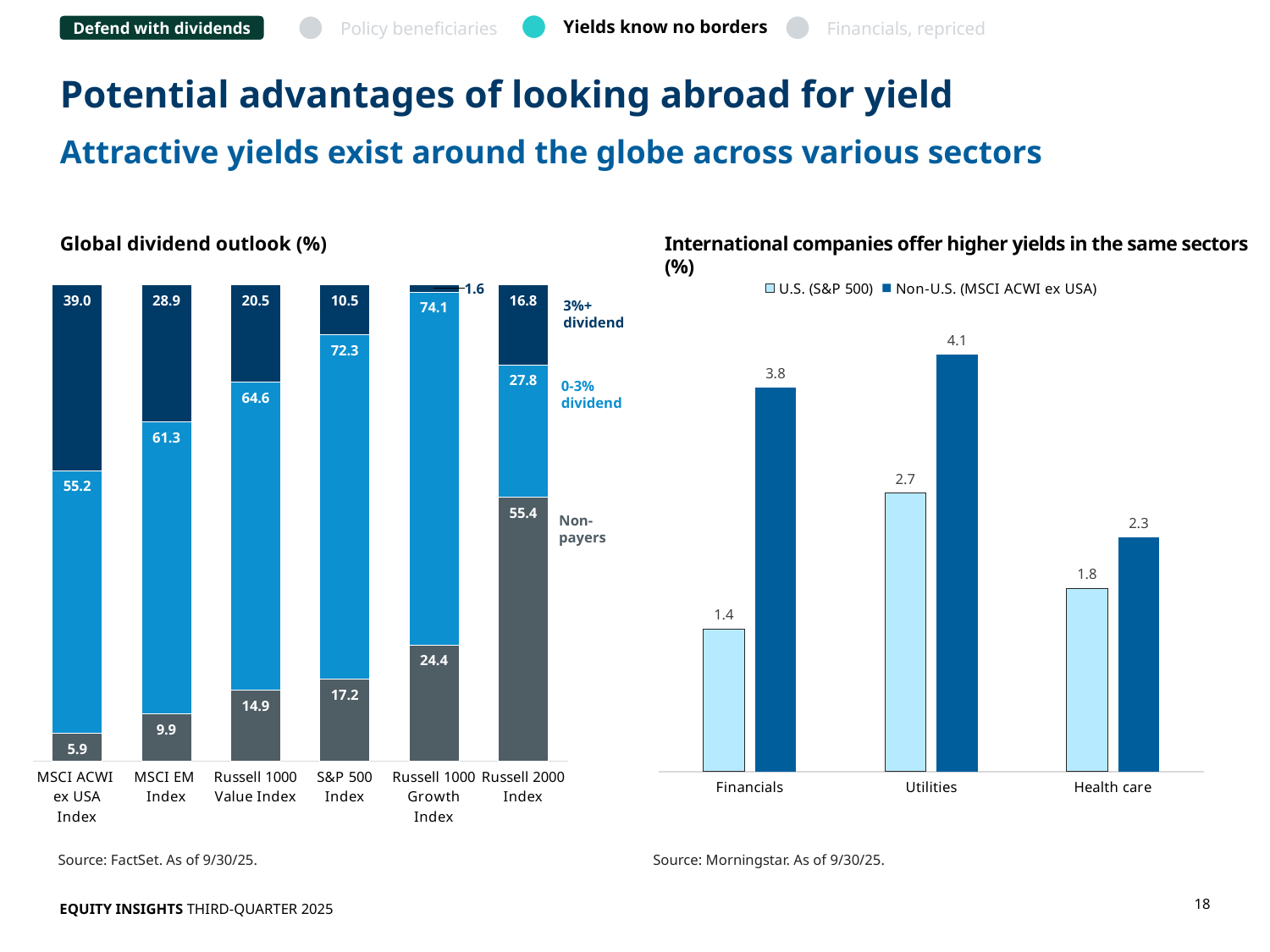
In the 'Global dividend outlook (%)' chart, which index has the lowest Non-payers value? MSCI ACWI ex USA Index In the 'Global dividend outlook (%)' chart, which index has the highest 0-3% dividend value? Russell 1000 Growth Index In the 'Global dividend outlook (%)' chart, what kind of chart is used? Stacked bar chart In the 'International companies offer higher yields in the same sectors (%)' chart, which is larger for Health care: the U.S. (S&P 500) value or the Non-U.S. (MSCI ACWI ex USA) value? Non-U.S. (MSCI ACWI ex USA) In the 'Global dividend outlook (%)' chart, what is the Non-payers value for the Russell 2000 Index? 55.4 In the 'International companies offer higher yields in the same sectors (%)' chart, what is the Non-U.S. (MSCI ACWI ex USA) value for Utilities? 4.1 In the 'Global dividend outlook (%)' chart, what is the 3%+ dividend value for the MSCI ACWI ex USA Index? 39.0 In the 'International companies offer higher yields in the same sectors (%)' chart, which sector has the lowest U.S. (S&P 500) value? Financials In the 'International companies offer higher yields in the same sectors (%)' chart, what is the difference between the Non-U.S. and U.S. values for Financials? 2.4 In the 'Global dividend outlook (%)' chart, how many indexes are shown on the x axis? 6 In the 'Global dividend outlook (%)' chart, what is the total of the stacked bar for the Russell 2000 Index? 100.0 In the 'International companies offer higher yields in the same sectors (%)' chart, how many series does the legend list? 2